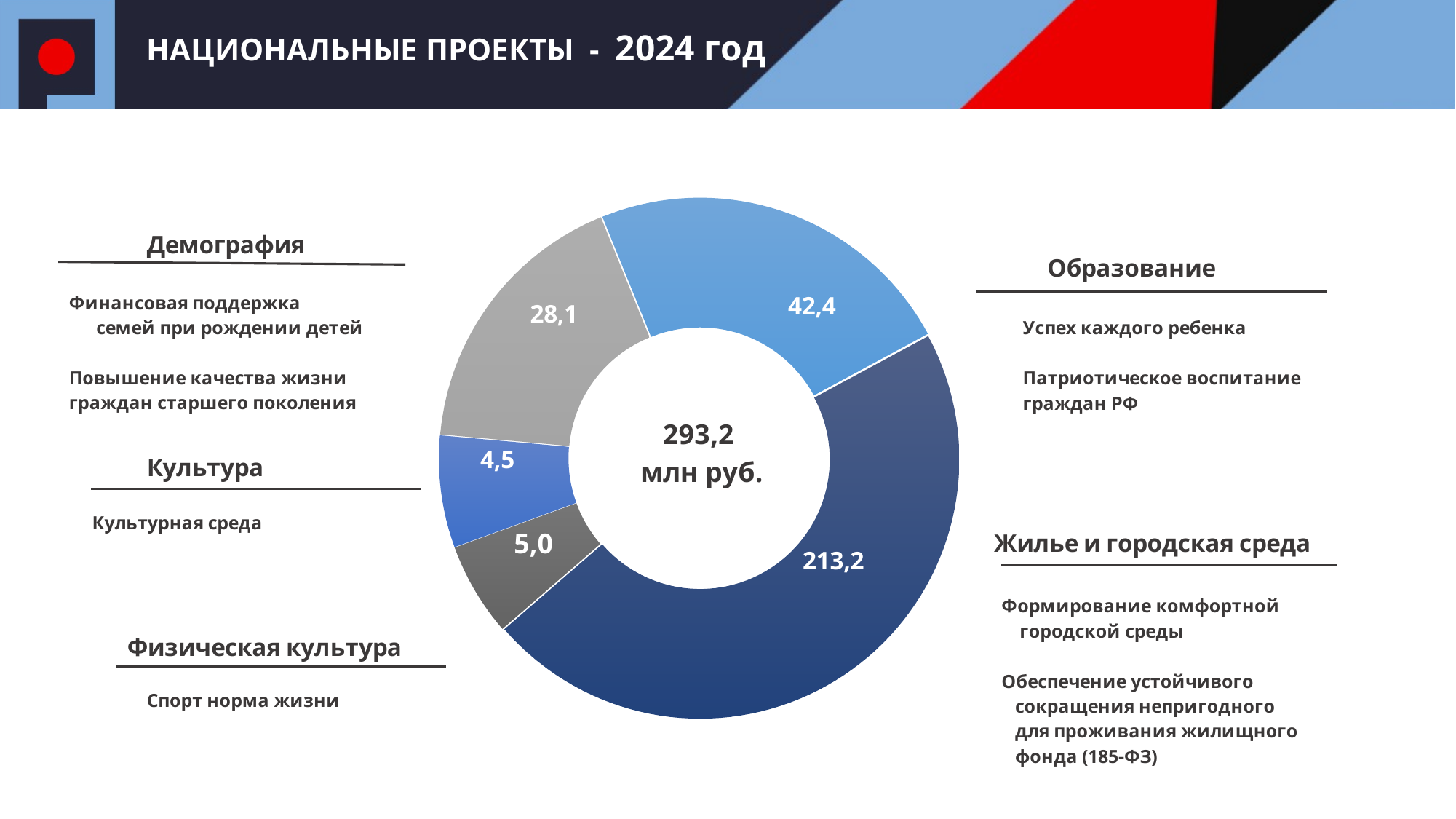
What is the value of the largest slice in the chart? 213,2 Which national project has the largest slice in the chart? Жилье и городская среда What is the value shown for Демография? 28,1 What is the value shown for Физическая культура? 5,0 What kind of chart is shown on the slide? Pie chart (donut) Which is larger: the slice for Физическая культура or the slice for Культура? Физическая культура What is the difference between the values for Образование (42,4) and Демография (28,1)? 14,3 What is the total value shown in the centre of the donut chart? 293,2 млн руб. Which national project has the smallest slice in the chart? Культура What is the value shown for Образование? 42,4 How many slices does the donut chart have? 5 What is the title of the slide containing the chart? НАЦИОНАЛЬНЫЕ ПРОЕКТЫ - 2024 год